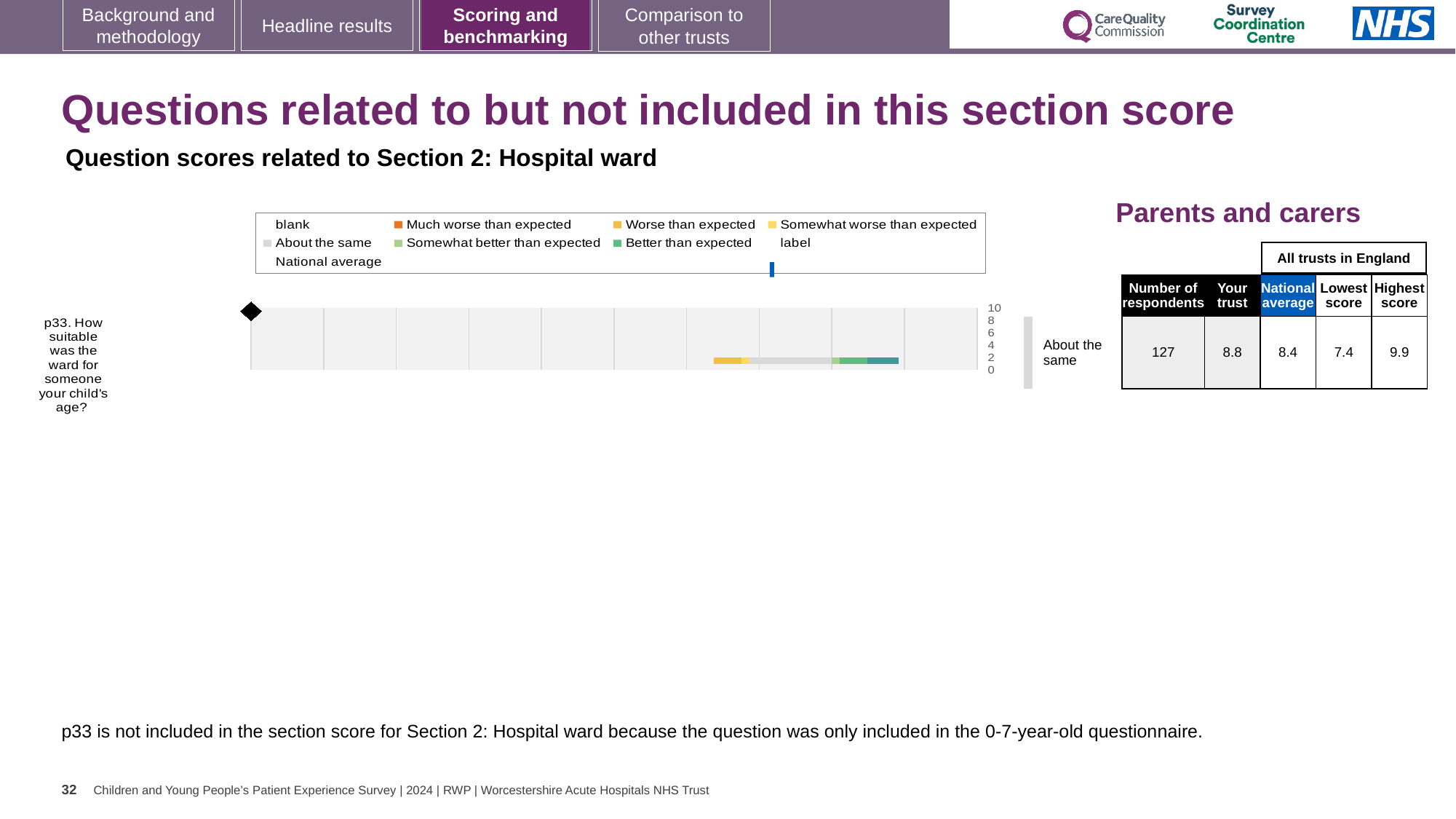
For p33, what is the difference between the Highest score and the Lowest score among all trusts in England? 2.5 In the table for p33, what is the Highest score among all trusts in England? 9.9 How many questions are plotted in the chart on this slide? 1 In the table for p33, what is the National average score? 8.4 What benchmark category is shown next to the bar for p33? About the same What is the highest tick value on the chart's axis? 10 What kind of chart is shown for question p33 on this slide? bar chart In the table for p33, what is the Lowest score among all trusts in England? 7.4 In the table for p33, what is the score for Your trust? 8.8 How many respondents are listed for p33? 127 For p33, which is larger: the Your trust score or the National average score? Your trust Which question is plotted in the chart on this slide? p33. How suitable was the ward for someone your child's age?